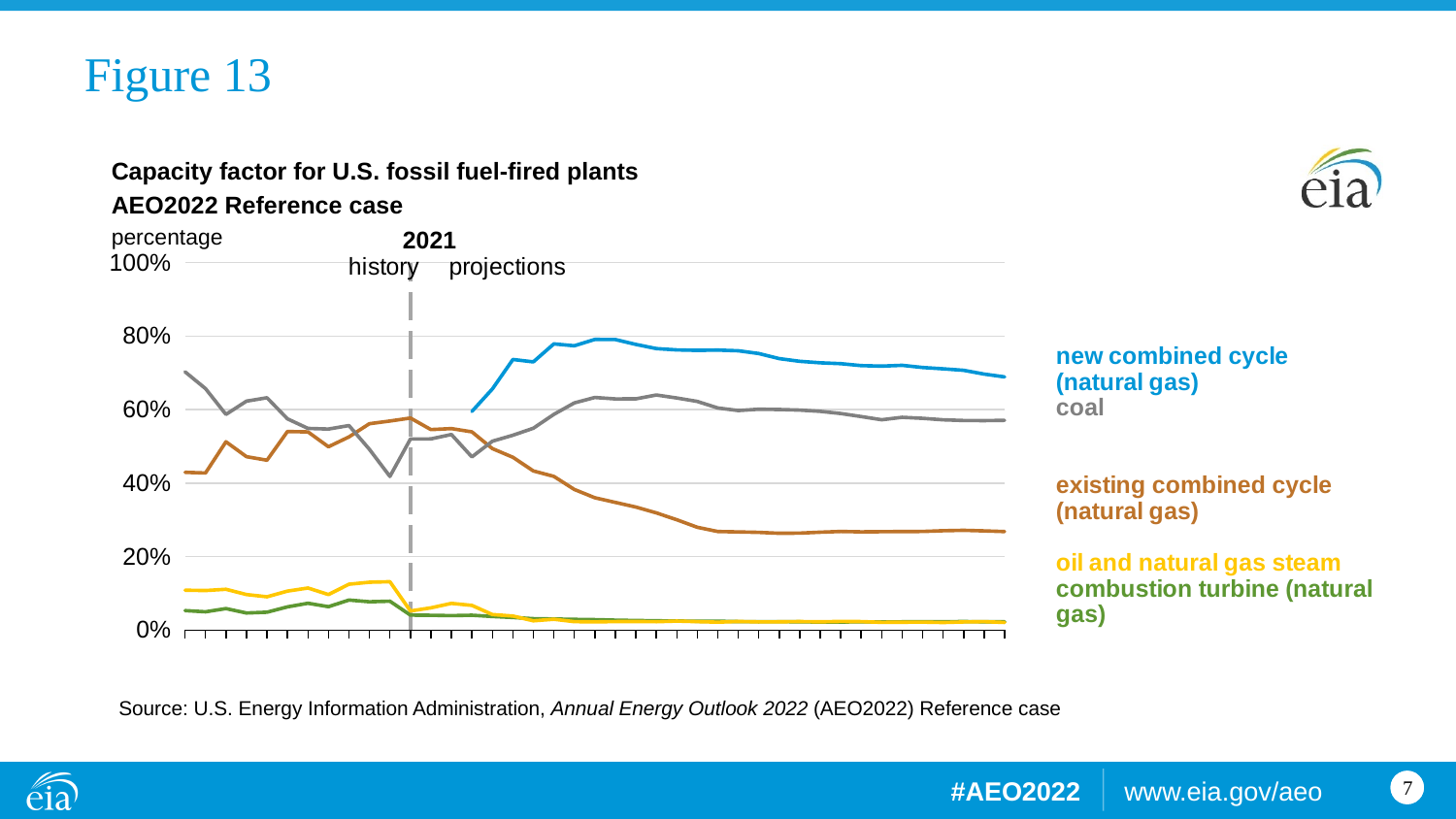
Is the capacity factor for existing combined cycle (natural gas) at the end of the projection period greater or less than 40%? less How many series are labelled on the chart? 5 At the end of the projection period, which has the higher capacity factor: coal or existing combined cycle (natural gas)? coal Is the capacity factor for new combined cycle (natural gas) at the end of the projection period greater or less than 60%? greater Which year does the dashed vertical line separating history from projections mark? 2021 Does the capacity factor for existing combined cycle (natural gas) rise or fall over the projection period? fall At the end of the projection period, which has the higher capacity factor: new combined cycle (natural gas) or coal? new combined cycle (natural gas) Is the capacity factor for existing combined cycle (natural gas) at the end of the projection period greater or less than 20%? greater What is the title of the chart? Capacity factor for U.S. fossil fuel-fired plants Which series has the highest capacity factor at the end of the projection period? new combined cycle (natural gas) What kind of chart is shown on the slide? line chart